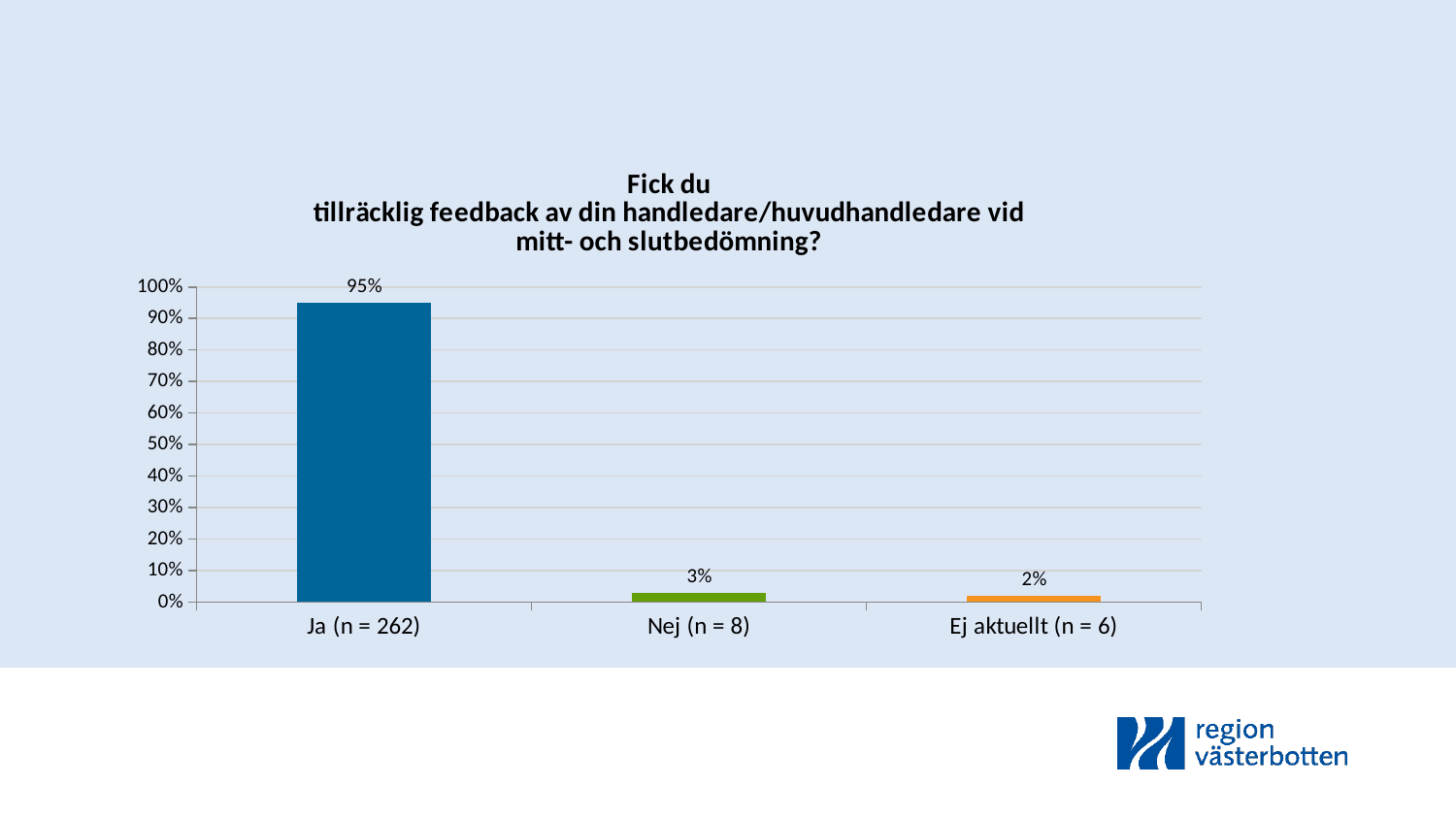
What is the value for "Nej (n = 8)"? 3% What kind of chart is shown on the slide? Bar chart Which is larger, the value for "Ja (n = 262)" or the value for "Nej (n = 8)"? Ja (n = 262) What is the difference between the values for "Nej (n = 8)" and "Ej aktuellt (n = 6)"? 1% What is the value for "Ja (n = 262)"? 95% What is the difference between the values for "Ja (n = 262)" and "Nej (n = 8)"? 92% Which category has the lowest value? Ej aktuellt (n = 6) How many categories are shown on the x axis? 3 Which category has the highest value? Ja (n = 262) How many respondents answered "Nej" according to the category label? 8 What is the value for "Ej aktuellt (n = 6)"? 2% Is the value for "Ja (n = 262)" greater or less than 90%? greater